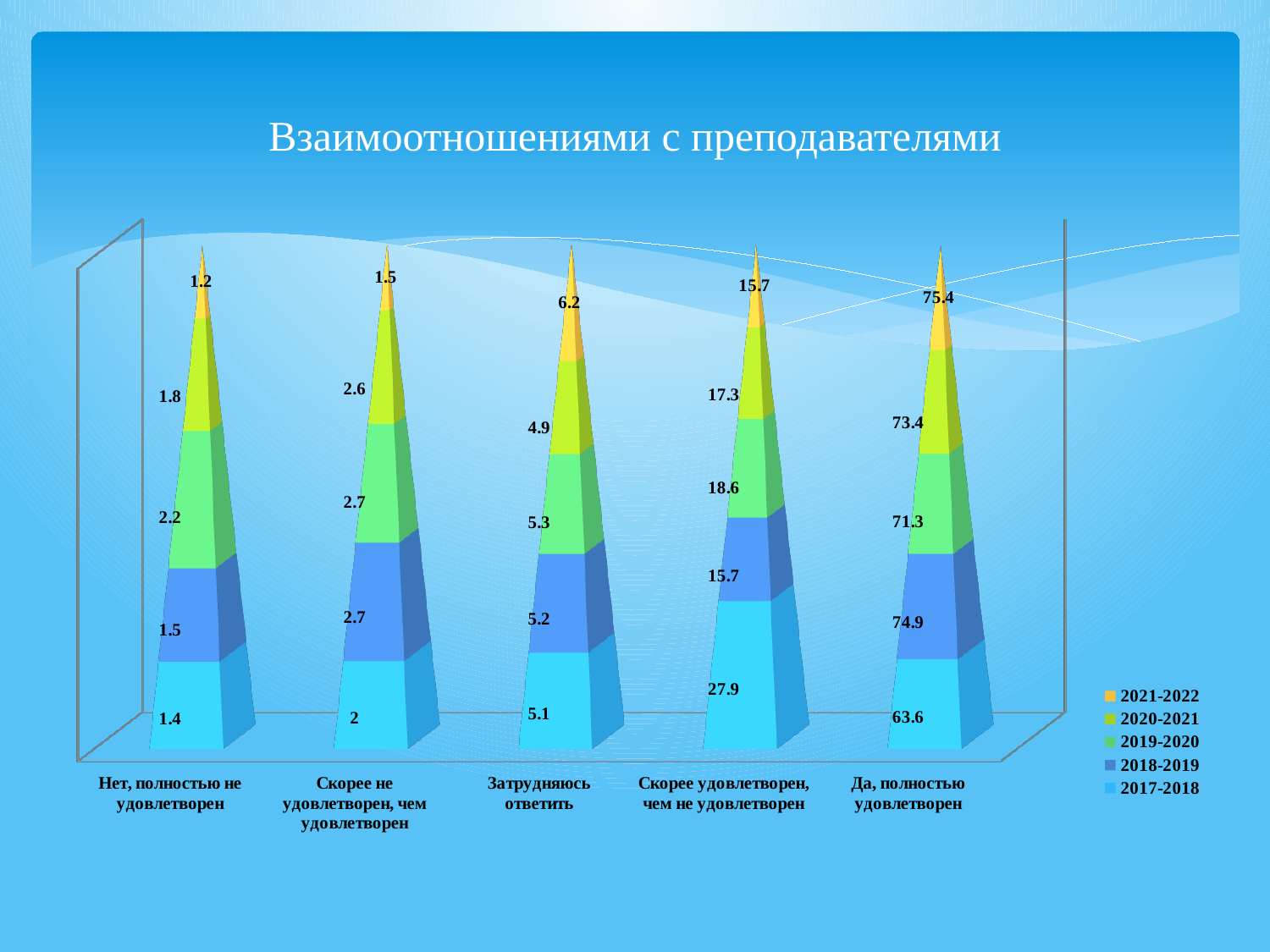
What kind of chart is shown on the slide? Stacked bar chart For "Скорее удовлетворен, чем не удовлетворен", which is larger: the 2017-2018 value or the 2018-2019 value? 2017-2018 What is the 2019-2020 value for "Затрудняюсь ответить"? 5.3 Which category has the lowest 2021-2022 value? Нет, полностью не удовлетворен Which category has the highest 2021-2022 value? Да, полностью удовлетворен What is the 2021-2022 value for "Скорее удовлетворен, чем не удовлетворен"? 15.7 What is the title of the chart? Взаимоотношениями с преподавателями What is the 2017-2018 value for "Да, полностью удовлетворен"? 63.6 How many series does the legend list? 5 What is the total of all five series for "Нет, полностью не удовлетворен"? 8.1 For "Да, полностью удовлетворен", how much higher is the 2021-2022 value than the 2017-2018 value? 11.8 How many categories are shown on the x axis? 5